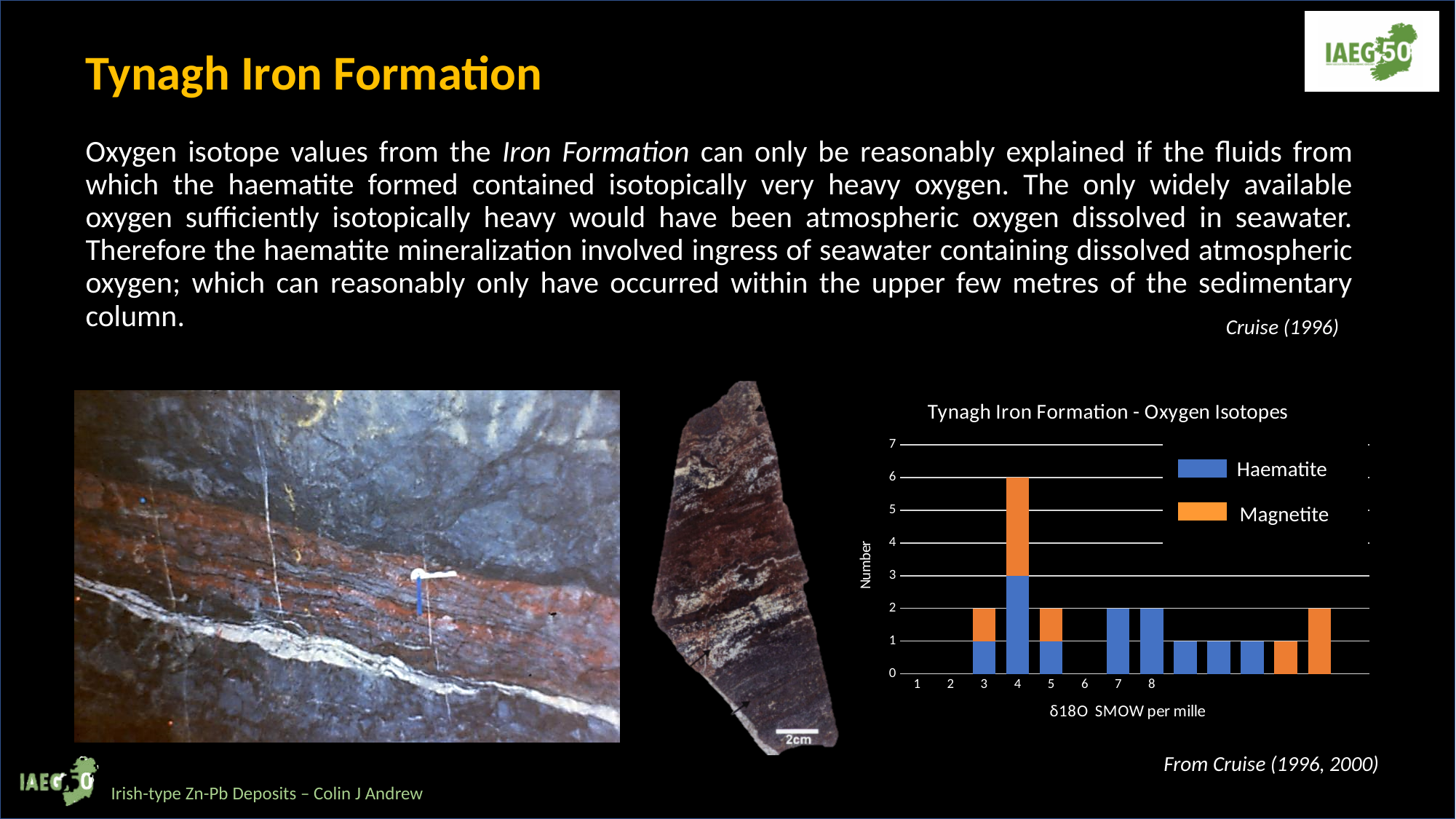
In the 'Tynagh Iron Formation - Oxygen Isotopes' chart, what is the Haematite count at δ18O value 4? 3 In the 'Tynagh Iron Formation - Oxygen Isotopes' chart, which stacked bar is taller, the one at δ18O value 4 or the one at δ18O value 7? 4 How many series does the legend of the 'Tynagh Iron Formation - Oxygen Isotopes' chart list? 2 In the 'Tynagh Iron Formation - Oxygen Isotopes' chart, what is the Haematite count at δ18O value 8? 2 In the 'Tynagh Iron Formation - Oxygen Isotopes' chart, is the total of the stacked bar at δ18O value 4 greater or less than 5? greater What is the title of the x axis on the 'Tynagh Iron Formation - Oxygen Isotopes' chart? δ18O SMOW per mille In the 'Tynagh Iron Formation - Oxygen Isotopes' chart, which δ18O value has the tallest stacked bar? 4 What kind of chart is 'Tynagh Iron Formation - Oxygen Isotopes'? Bar chart What are the two series named in the legend of the 'Tynagh Iron Formation - Oxygen Isotopes' chart? Haematite and Magnetite In the 'Tynagh Iron Formation - Oxygen Isotopes' chart, what is the total height of the stacked bar at δ18O value 4? 6 In the 'Tynagh Iron Formation - Oxygen Isotopes' chart, what is the total height of the stacked bar at δ18O value 3? 2 In the 'Tynagh Iron Formation - Oxygen Isotopes' chart, what is the Haematite count at δ18O value 7? 2